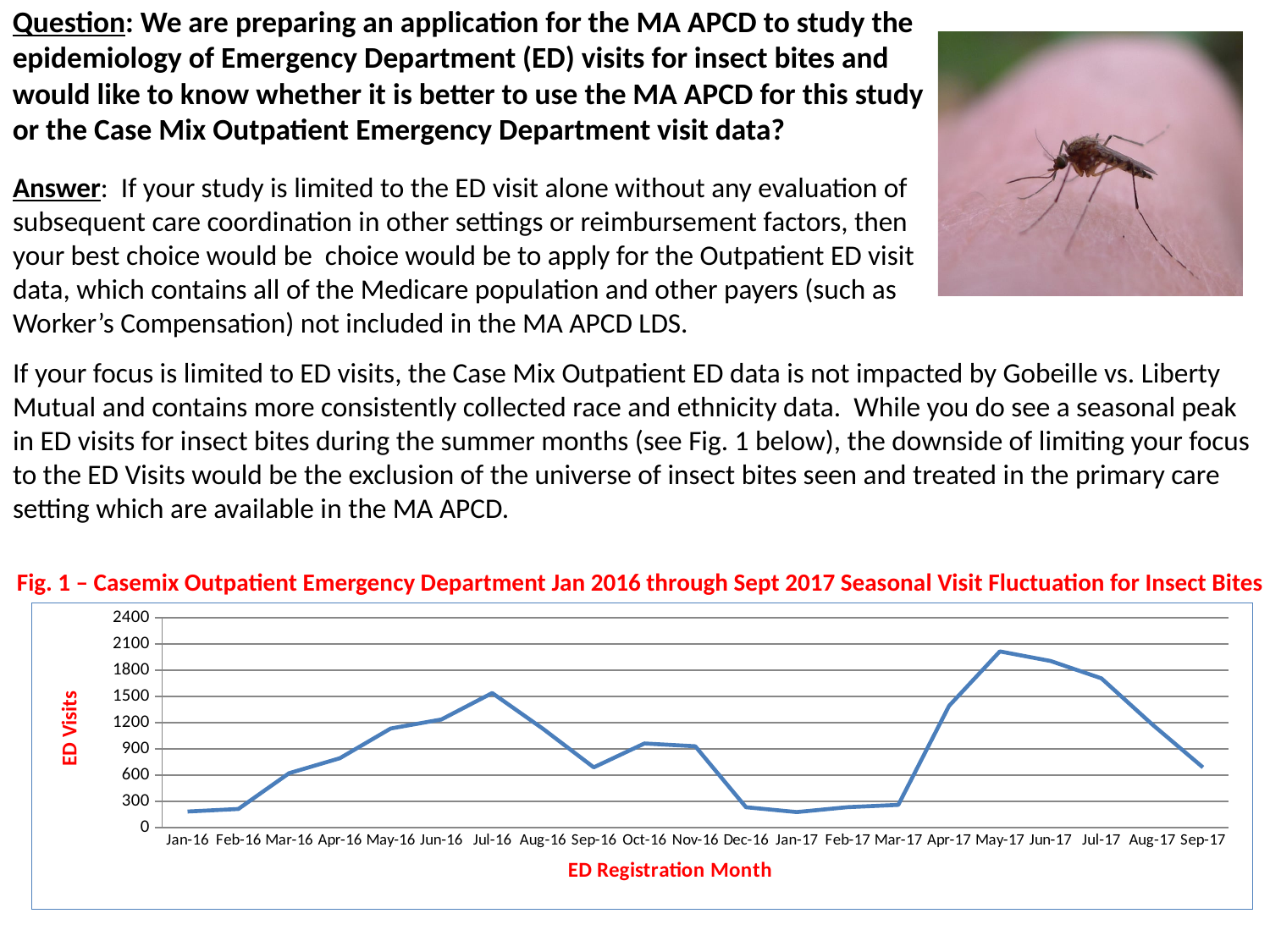
Is the value for Sep-17 greater or less than 900? less Is the value for Apr-17 greater or less than 1200? greater Do ED visits rise or fall from Jan-16 to Jul-16? rise Which month has more ED visits, Jul-16 or May-17? May-17 What is the label on the y axis of the chart? ED Visits Is the value for Jul-16 greater or less than 1200? greater Which month has the highest number of ED visits in the chart? May-17 Which month has more ED visits, Oct-16 or Dec-16? Oct-16 What kind of chart is shown in Fig. 1? line chart How many months are plotted on the x axis of the chart? 21